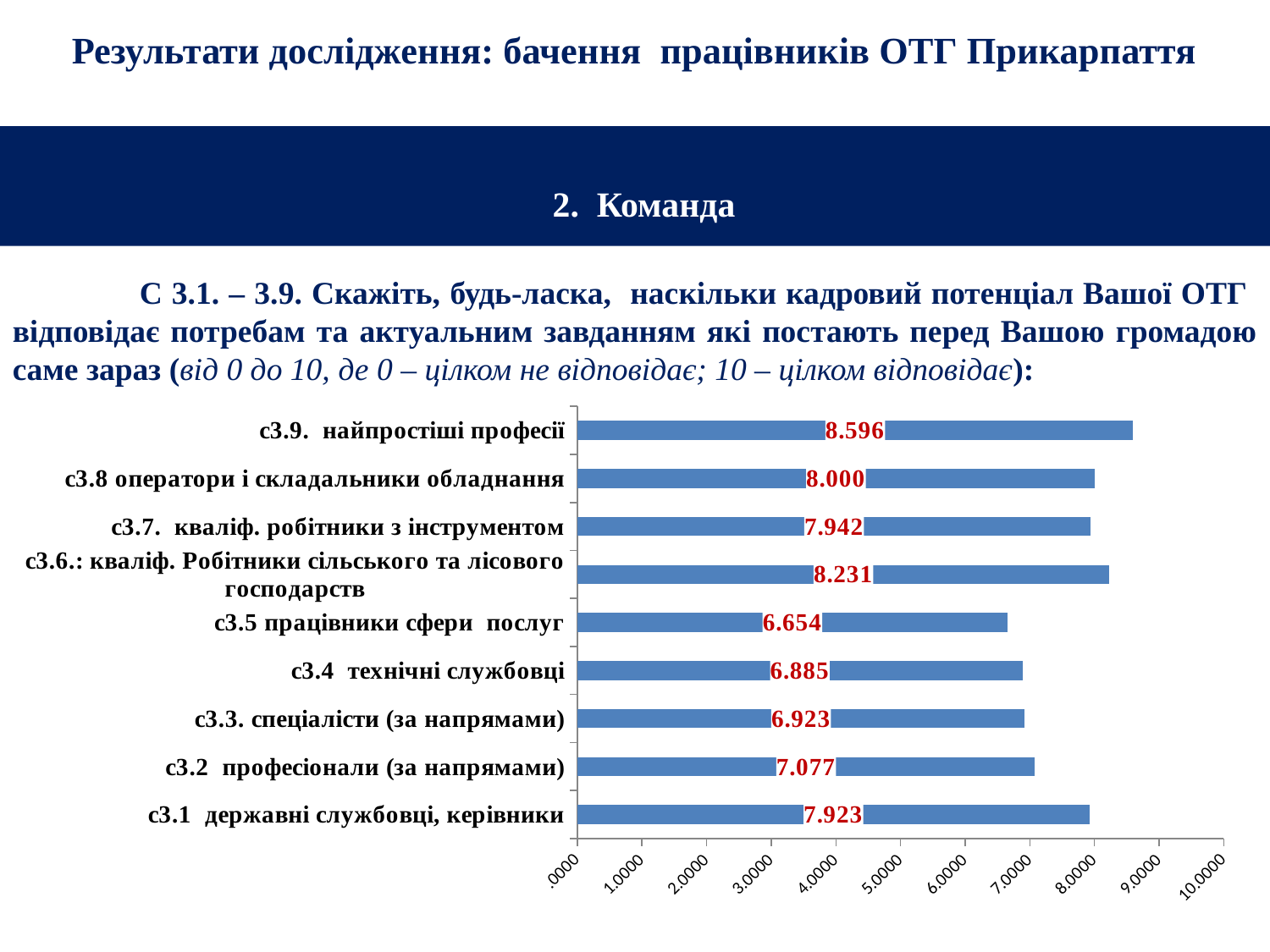
How many categories are shown in the chart? 9 Which is larger: the value for "с3.6.: кваліф. Робітники сільського та лісового господарств" or for "с3.8 оператори і складальники обладнання"? с3.6.: кваліф. Робітники сільського та лісового господарств What is the value for "с3.9. найпростіші професії"? 8.596 What is the difference between the values for "с3.9. найпростіші професії" and "с3.5 працівники сфери послуг"? 1.942 What is the value for "с3.5 працівники сфери послуг"? 6.654 What is the maximum value shown on the horizontal axis of the chart? 10.0000 What is the value for "с3.1 державні службовці, керівники"? 7.923 Which category has the highest value? с3.9. найпростіші професії What kind of chart is shown on the slide? bar chart Is the value for "с3.2 професіонали (за напрямами)" greater or less than 8.0000? less What is the value for "с3.6.: кваліф. Робітники сільського та лісового господарств"? 8.231 Which category has the lowest value? с3.5 працівники сфери послуг